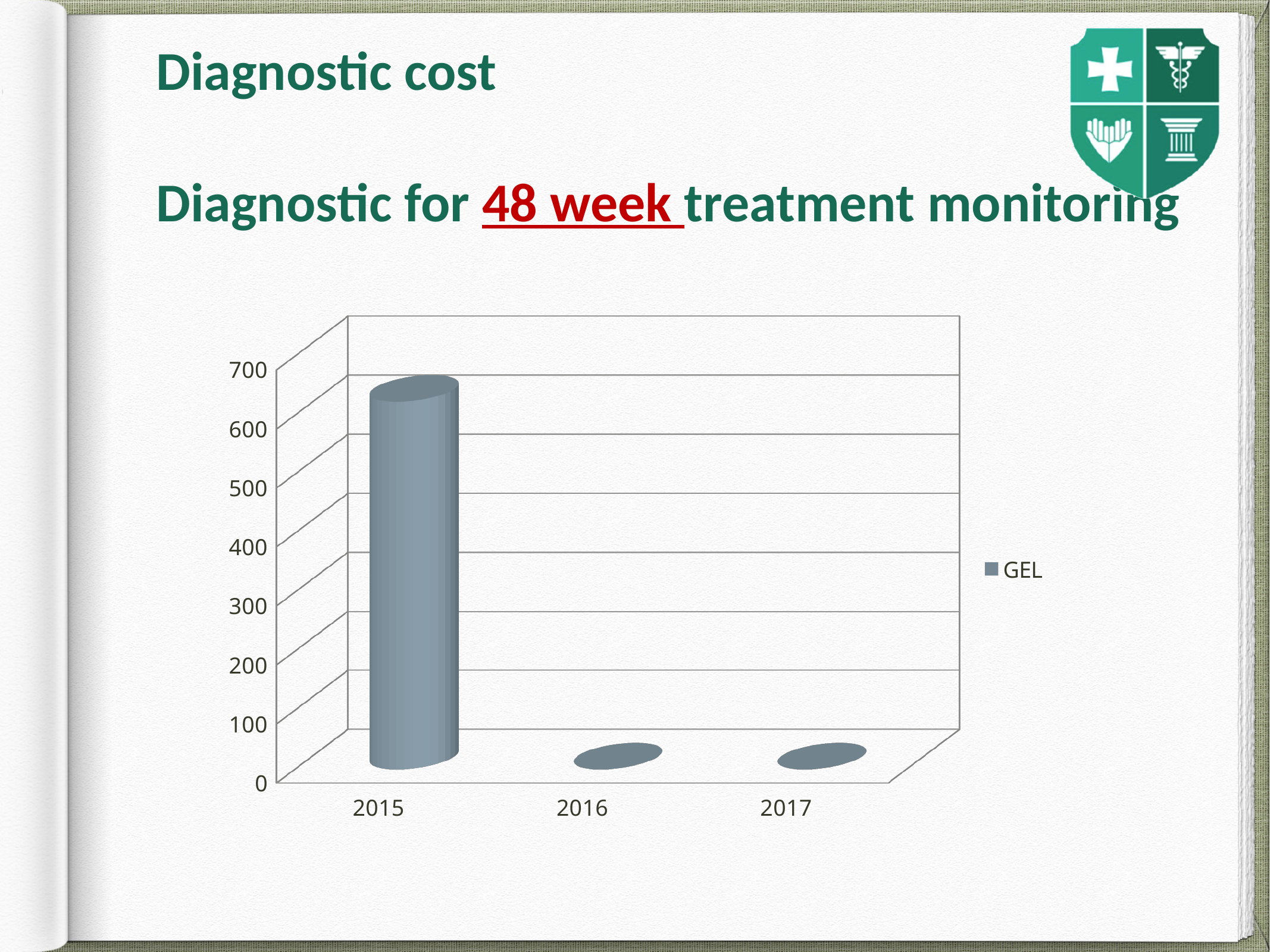
Is the value for 2016 greater or less than 100? less Which year has the highest value in the chart? 2015 How many series does the chart legend list? 1 Which is larger, the value for 2015 or the value for 2016? 2015 What is the highest value shown on the vertical axis of the chart? 700 How many categories are shown on the x axis of the chart? 3 What kind of chart is shown on the slide? bar chart Which is larger, the value for 2017 or the value for 2015? 2015 Is the value for 2017 greater or less than 100? less What is the name of the series shown in the chart legend? GEL Do the values rise or fall from 2015 to 2017? fall Is the value for 2015 greater or less than 500? greater